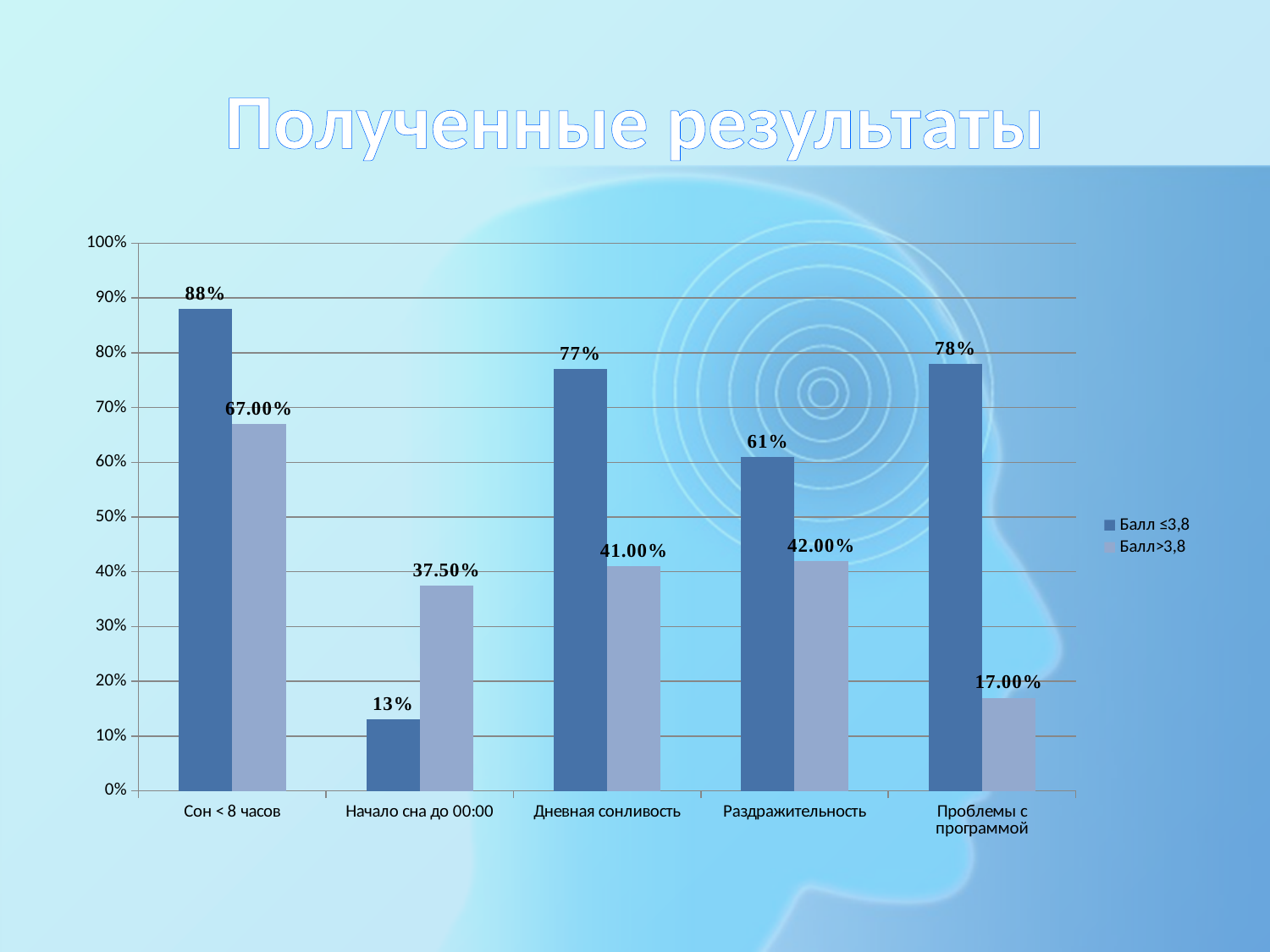
What is the value for 'Проблемы с программой' in the 'Балл>3,8' series? 17.00% How many categories are shown on the x axis? 5 What is the difference between the 'Балл ≤3,8' values for 'Сон < 8 часов' and 'Начало сна до 00:00'? 75% What is the value for 'Раздражительность' in the 'Балл ≤3,8' series? 61% Which is larger for 'Дневная сонливость': the 'Балл ≤3,8' value or the 'Балл>3,8' value? Балл ≤3,8 How many series does the legend list? 2 What is the value for 'Сон < 8 часов' in the 'Балл ≤3,8' series? 88% What is the value for 'Начало сна до 00:00' in the 'Балл>3,8' series? 37.50% Which category has the highest value in the 'Балл ≤3,8' series? Сон < 8 часов Which category has the lowest value in the 'Балл ≤3,8' series? Начало сна до 00:00 What type of chart is shown on the slide? bar chart Which category has the highest value in the 'Балл>3,8' series? Сон < 8 часов